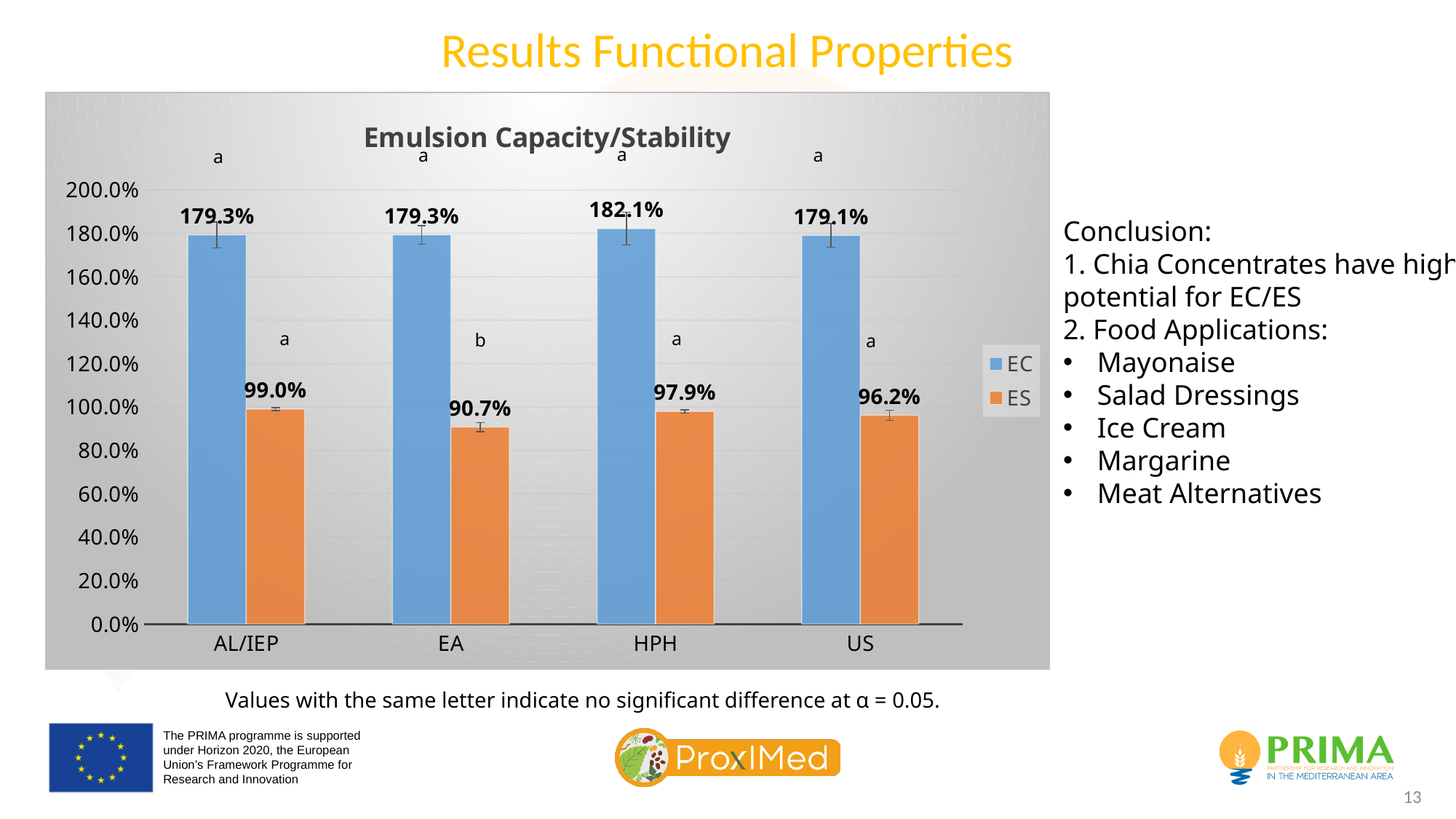
What is the title of the chart? Emulsion Capacity/Stability How many categories are shown on the x axis? 4 How many series does the legend list? 2 What is the EC value for HPH? 182.1% What is the ES value for AL/IEP? 99.0% Which category has the lowest ES value? EA What is the difference between the EC and ES values for HPH? 84.2% What kind of chart is shown? Bar chart What is the ES value for EA? 90.7% Which category has the highest EC value? HPH Which is larger, the ES value for AL/IEP or the ES value for US? AL/IEP What is the EC value for US? 179.1%